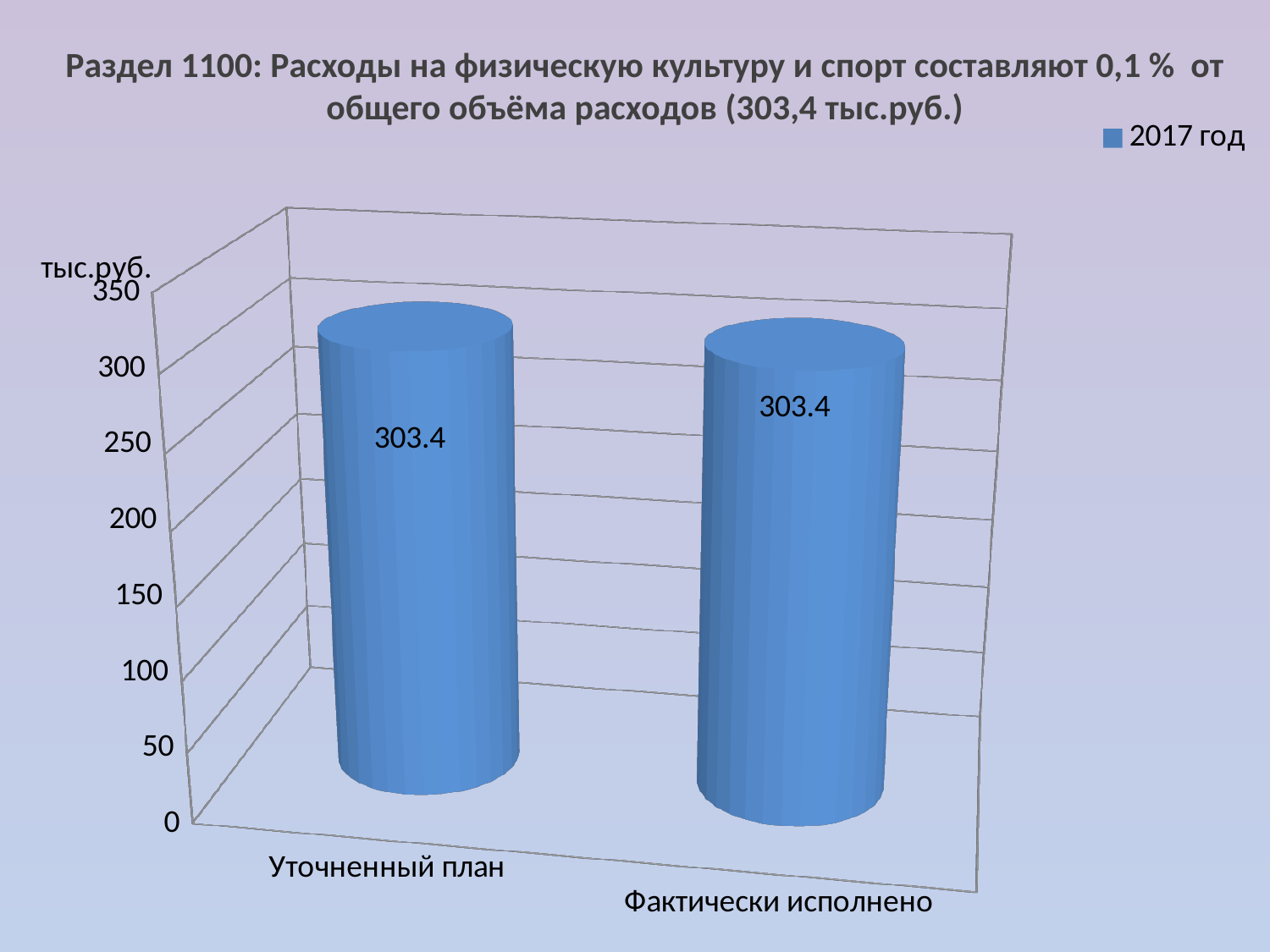
What series name is shown in the chart legend? 2017 год Is the value for Фактически исполнено larger than, smaller than, or equal to the value for Уточненный план? equal How many series does the legend list? 1 Is the value for Уточненный план greater or less than 250? greater Is the value for Фактически исполнено greater or less than 350? less What is the value for Фактически исполнено? 303.4 What is the difference between the values for Уточненный план and Фактически исполнено? 0 What is the total of the two values shown in the chart? 606.8 What is the value for Уточненный план? 303.4 What kind of chart is shown on the slide? bar chart How many categories are shown on the x axis of the chart? 2 What unit is shown on the vertical axis of the chart? тыс.руб.